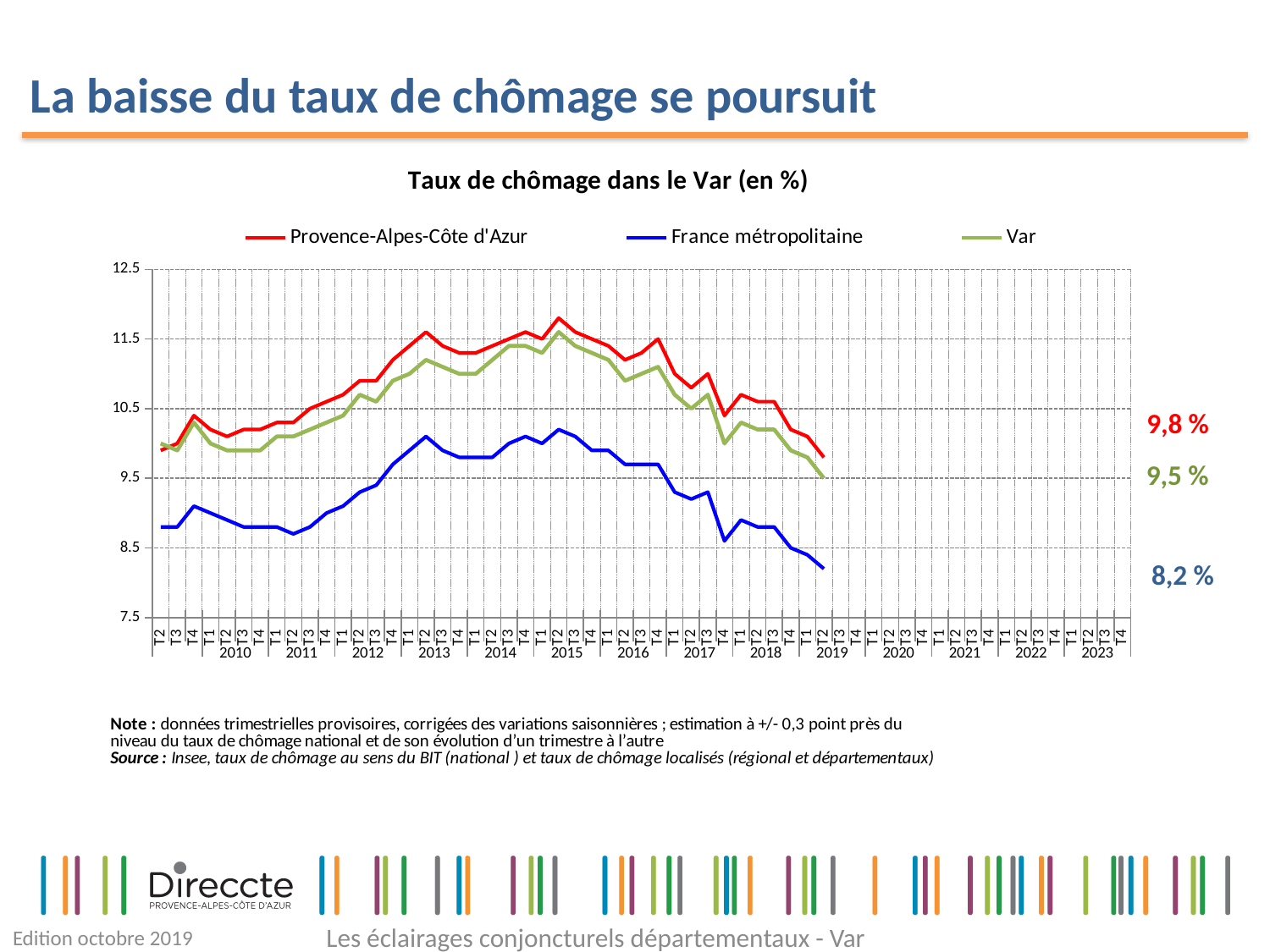
What kind of chart is shown on the slide? line chart How many series does the legend list? 3 What is the title of the chart? Taux de chômage dans le Var (en %) Which series has the lowest values across the whole period? France métropolitaine From 2017 to 2019, do the unemployment rates rise or fall? fall At the latest point, which is larger: Var or France métropolitaine? Var What is the latest labelled value for France métropolitaine? 8,2 % What is the latest labelled value for Var? 9,5 % What is the latest labelled value for Provence-Alpes-Côte d'Azur? 9,8 % What is the difference between the latest labelled values for Provence-Alpes-Côte d'Azur and France métropolitaine? 1,6 Is the peak value for Provence-Alpes-Côte d'Azur in 2015 greater or less than 11.5? greater What is the difference between the latest labelled values for Provence-Alpes-Côte d'Azur and Var? 0,3